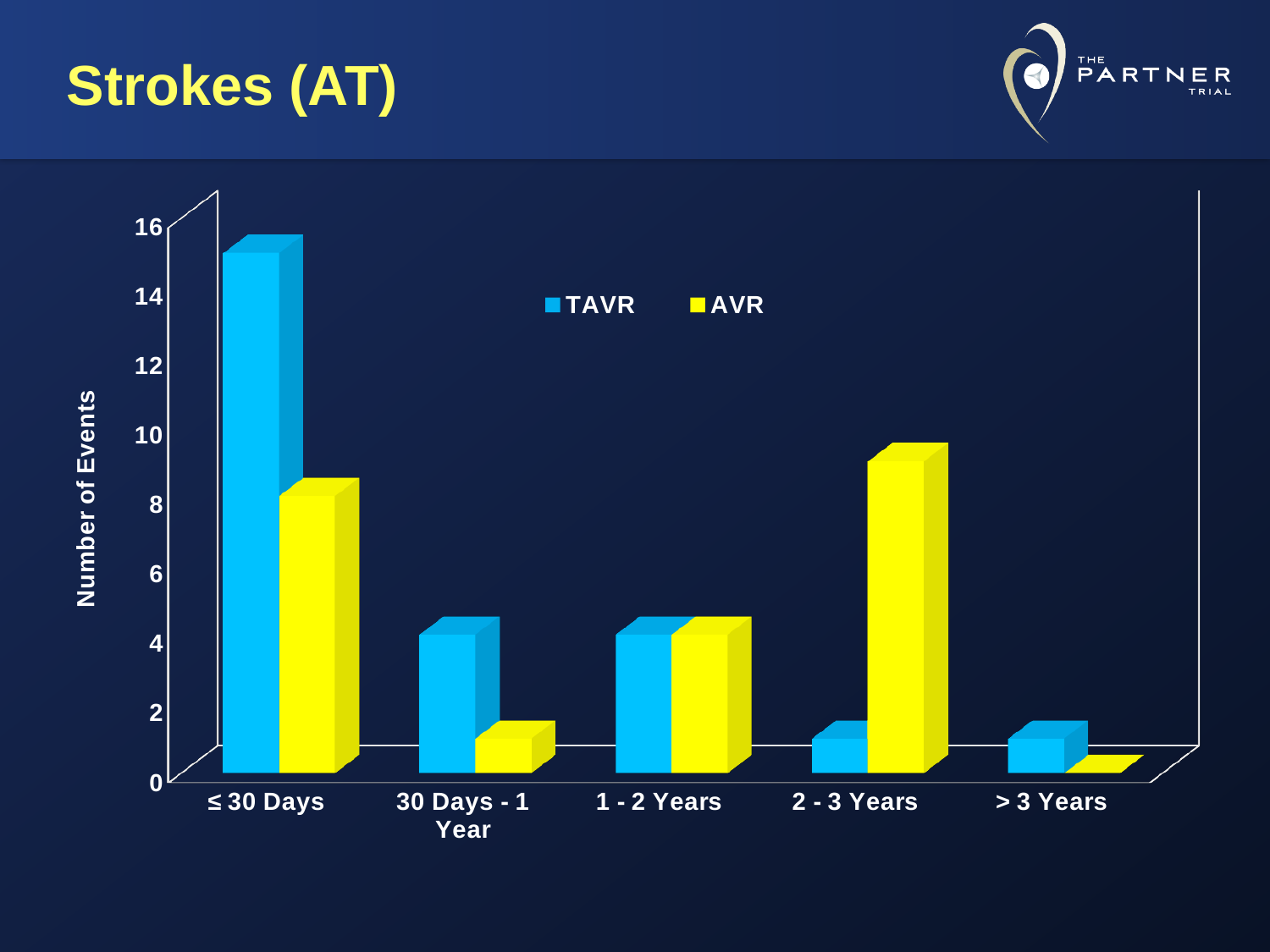
In which time period is the AVR bar lowest? > 3 Years For 2 - 3 Years, which group has more events, TAVR or AVR? AVR Is the AVR value for ≤ 30 Days greater or less than 10? less For ≤ 30 Days, which group has more events, TAVR or AVR? TAVR What is the label on the vertical axis? Number of Events Is the TAVR value for ≤ 30 Days greater or less than 12? greater How many series does the legend list? 2 How many time-period categories are shown on the x axis? 5 What kind of chart is shown on the slide? bar chart Is the AVR value for 2 - 3 Years greater or less than 6? greater In which time period is the TAVR bar highest? ≤ 30 Days In which time period is the AVR bar highest? 2 - 3 Years